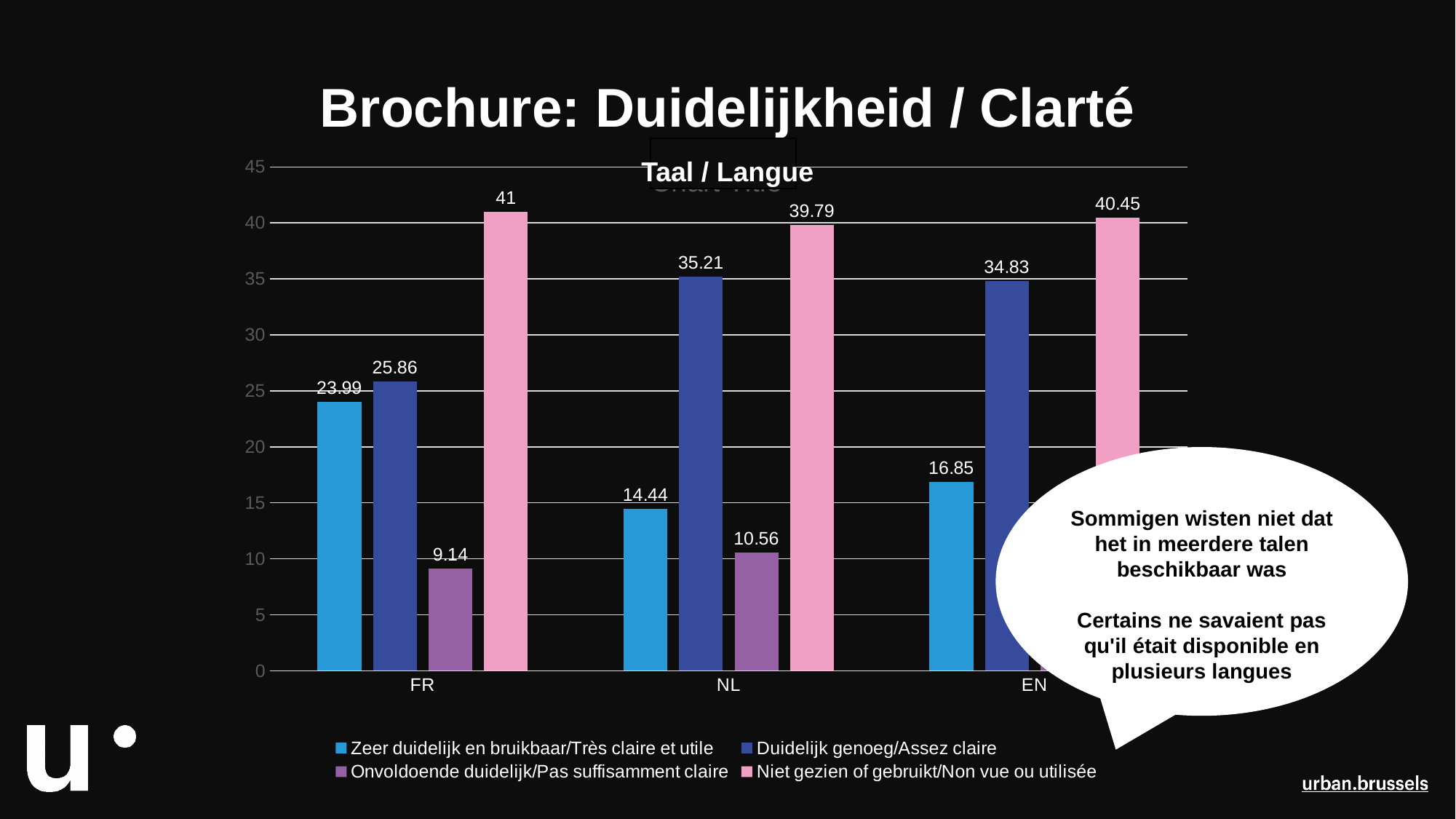
How many series does the legend list? 4 Is the value for 'Onvoldoende duidelijk/Pas suffisamment claire' for FR greater or less than 10? less What is the value for 'Duidelijk genoeg/Assez claire' for NL? 35.21 Which language has the lowest value for 'Zeer duidelijk en bruikbaar/Très claire et utile'? NL What is the value for 'Niet gezien of gebruikt/Non vue ou utilisée' for EN? 40.45 Which is larger for FR: 'Zeer duidelijk en bruikbaar/Très claire et utile' or 'Duidelijk genoeg/Assez claire'? Duidelijk genoeg/Assez claire What is the difference between the 'Duidelijk genoeg/Assez claire' values for NL and FR? 9.35 Which language has the highest value for 'Niet gezien of gebruikt/Non vue ou utilisée'? FR How many language categories are shown on the x axis? 3 What is the value for 'Onvoldoende duidelijk/Pas suffisamment claire' for NL? 10.56 What is the value for 'Zeer duidelijk en bruikbaar/Très claire et utile' for FR? 23.99 What kind of chart is shown on the slide? Bar chart